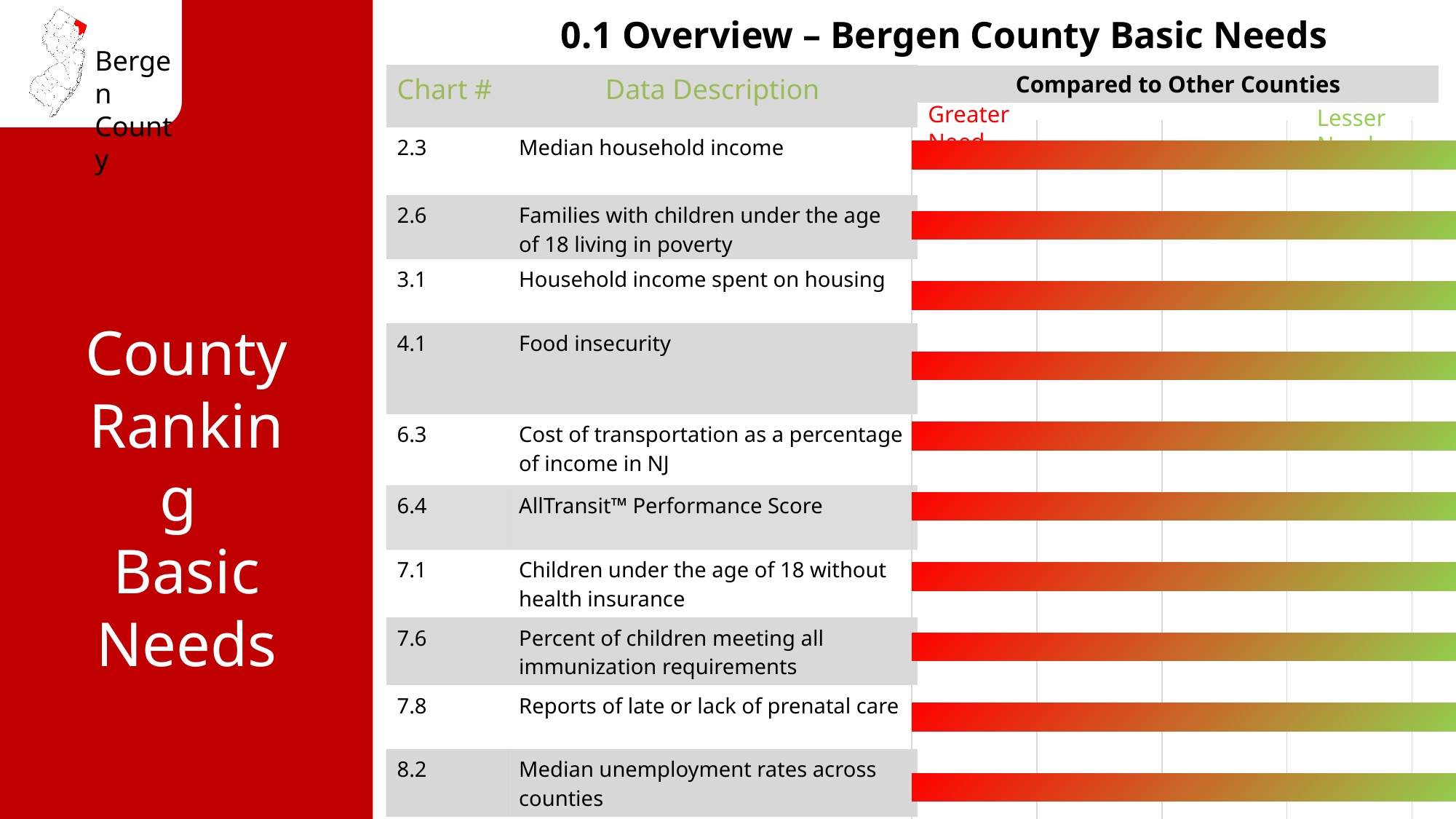
What is the title of the slide containing the chart? 0.1 Overview – Bergen County Basic Needs Which data description is listed for chart number 7.8? Reports of late or lack of prenatal care Which chart number is listed for 'AllTransit™ Performance Score'? 6.4 Which data description is listed for chart number 2.3? Median household income What is the heading above the bars in the chart? Compared to Other Counties How many horizontal bars are plotted in the chart? 10 What kind of chart is shown on the right side of the slide? bar chart Which chart number is listed for the data description 'Food insecurity'? 4.1